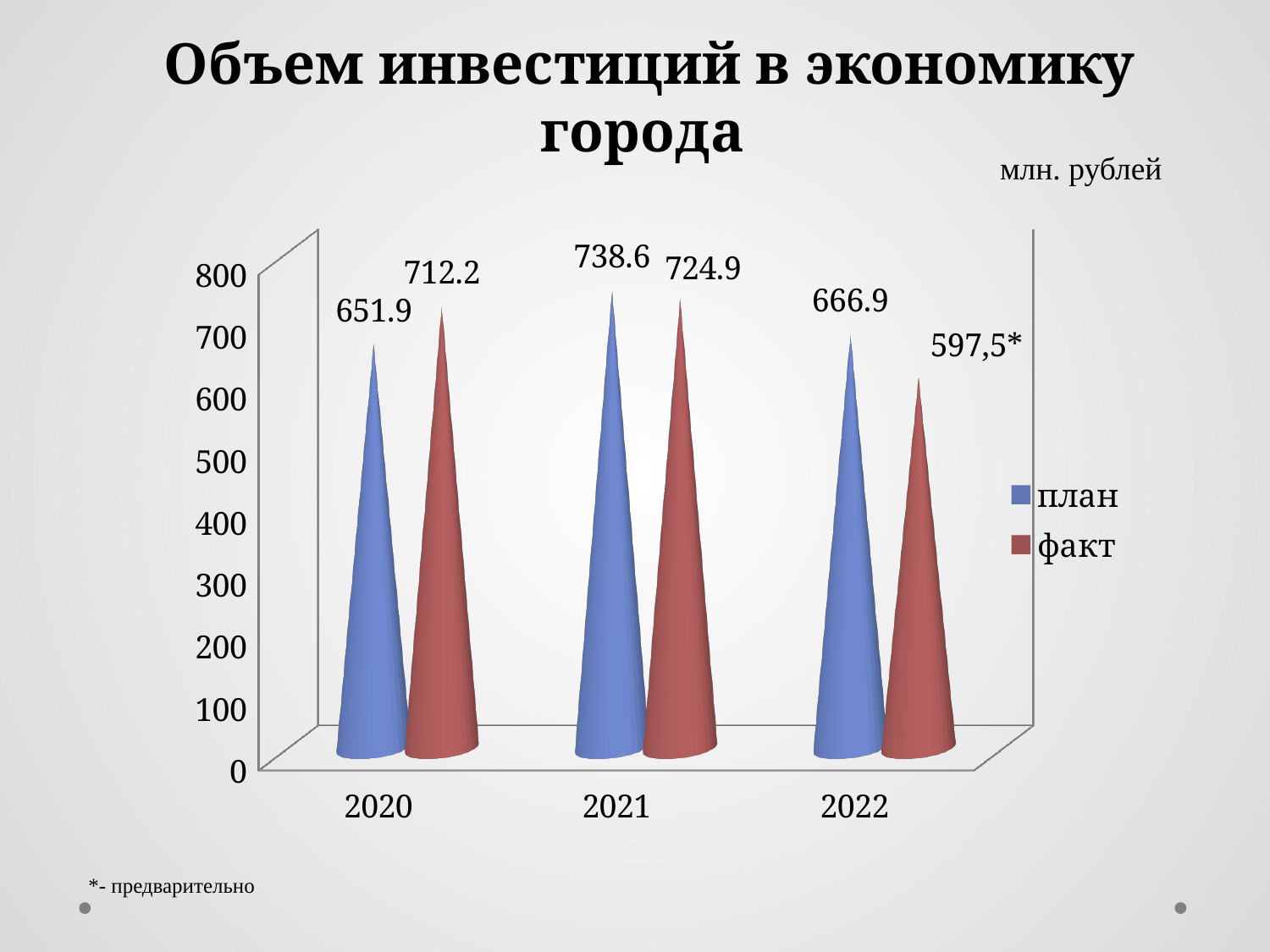
In which year is the план value highest? 2021 How many series does the legend list? 2 What is the план value for 2021? 738.6 What is the difference between the план and факт values for 2022? 69.4 Is the факт value for 2022 greater or less than 600? less How many years are shown on the x axis? 3 What is the факт value for 2020? 712.2 What kind of chart is shown on the slide? bar chart What is the difference between the факт and план values for 2020? 60.3 Which is larger for 2021, план or факт? план What is the факт value for 2022? 597,5* In which year is the факт value lowest? 2022